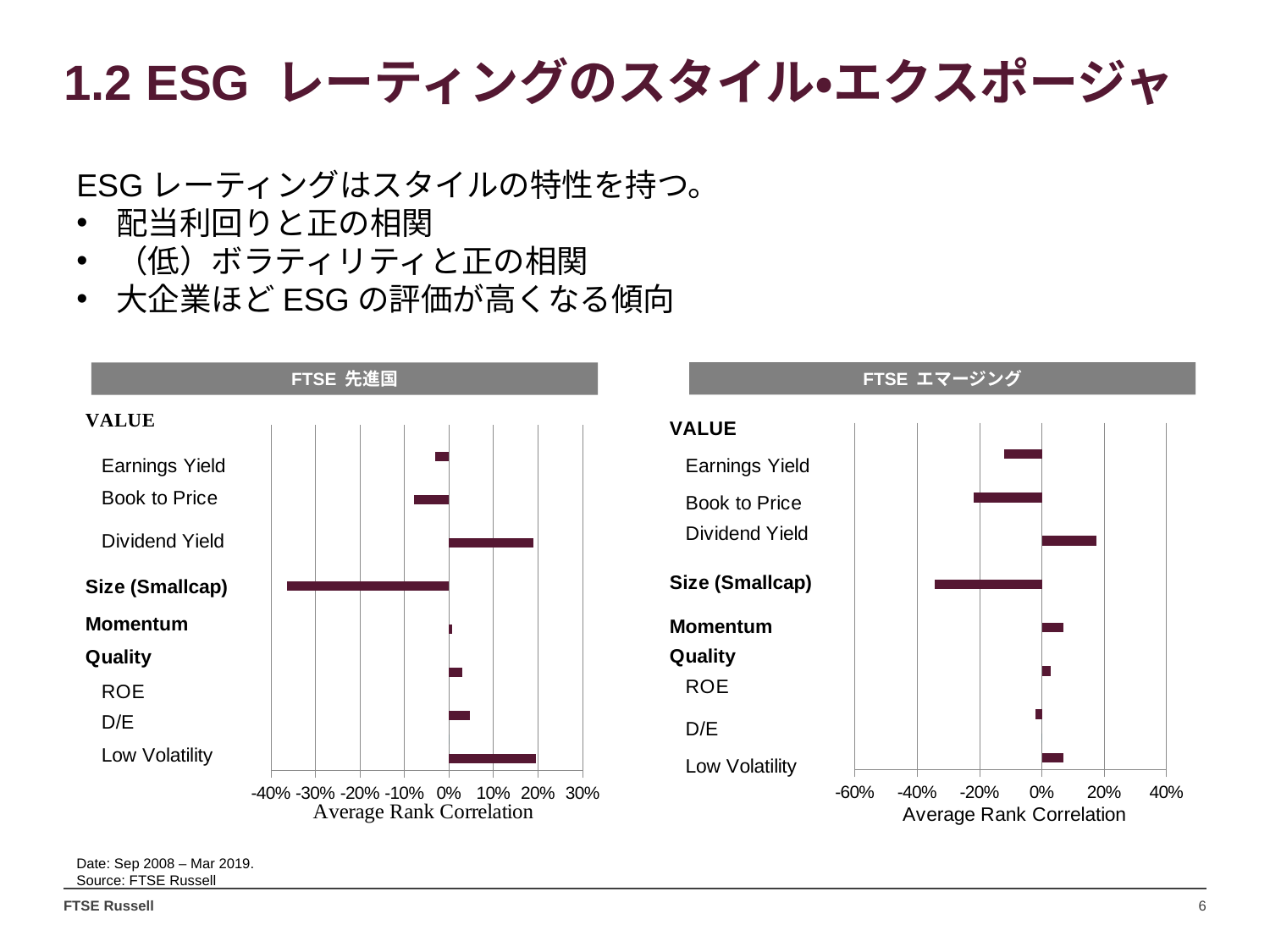
In the FTSE エマージング chart, which category has the highest value? Dividend Yield In the FTSE 先進国 chart, is the value for Dividend Yield greater or less than 10%? greater In the FTSE エマージング chart, is the value for Book to Price greater or less than 0%? less In the FTSE エマージング chart, is the value for Size (Smallcap) greater or less than -20%? less In the FTSE エマージング chart, which category has the lowest value? Size (Smallcap) How many bars are plotted in the FTSE エマージング chart? 8 In the FTSE 先進国 chart, which is larger, the value for Earnings Yield or the value for Book to Price? Earnings Yield In the FTSE エマージング chart, which is larger, the value for Momentum or the value for ROE? Momentum What is the x-axis title of the FTSE 先進国 chart? Average Rank Correlation In the FTSE 先進国 chart, which category has the lowest value? Size (Smallcap) What kind of chart is the FTSE 先進国 chart? bar chart